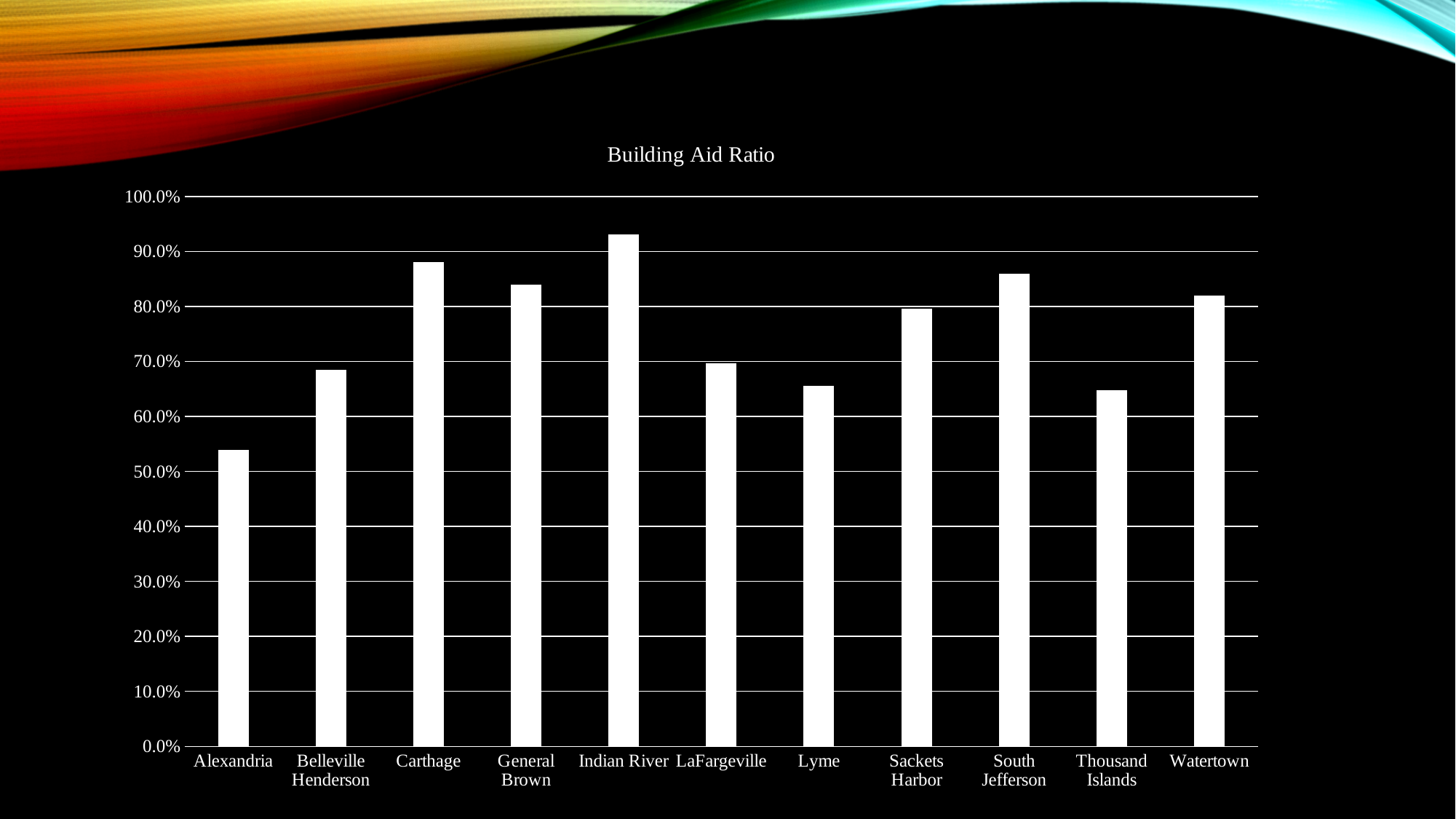
Is the value for Carthage greater or less than 80.0%? greater Is the value for Thousand Islands greater or less than 70.0%? less Which district has the lowest Building Aid Ratio? Alexandria What kind of chart is shown on the slide? bar chart Which has the higher Building Aid Ratio, Carthage or General Brown? Carthage How many districts are shown on the x axis of the chart? 11 What is the title of the chart? Building Aid Ratio Which has the higher Building Aid Ratio, Alexandria or Lyme? Lyme Which has the higher Building Aid Ratio, Sackets Harbor or Watertown? Watertown Which district has the highest Building Aid Ratio? Indian River Is the value for Indian River greater or less than 90.0%? greater